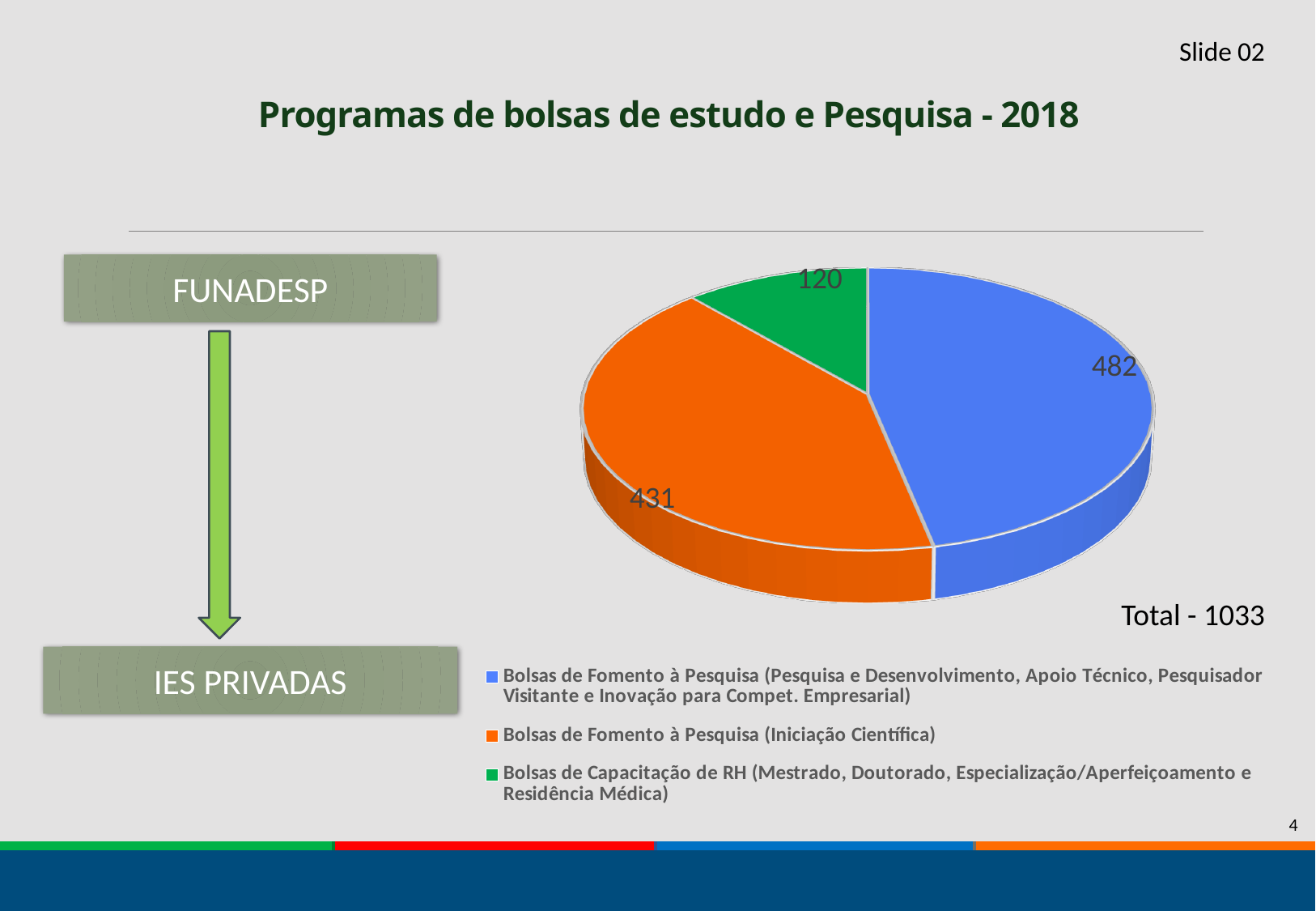
What total is printed next to the pie chart? Total - 1033 What is the value for Bolsas de Capacitação de RH (Mestrado, Doutorado, Especialização/Aperfeiçoamento e Residência Médica)? 120 What is the difference between the value for Bolsas de Fomento à Pesquisa (Iniciação Científica) and the value for Bolsas de Capacitação de RH? 311 Which is larger: the slice for Bolsas de Fomento à Pesquisa (Iniciação Científica) or the slice for Bolsas de Capacitação de RH? Bolsas de Fomento à Pesquisa (Iniciação Científica) Which category has the smallest slice of the pie? Bolsas de Capacitação de RH (Mestrado, Doutorado, Especialização/Aperfeiçoamento e Residência Médica) What is the difference between the largest slice (482) and the Iniciação Científica slice (431)? 51 What kind of chart is shown on the slide? Pie chart What colour is the slice for Bolsas de Fomento à Pesquisa (Iniciação Científica)? Orange Which category has the largest slice of the pie? Bolsas de Fomento à Pesquisa (Pesquisa e Desenvolvimento, Apoio Técnico, Pesquisador Visitante e Inovação para Compet. Empresarial) What is the value for Bolsas de Fomento à Pesquisa (Pesquisa e Desenvolvimento, Apoio Técnico, Pesquisador Visitante e Inovação para Compet. Empresarial)? 482 What is the value for Bolsas de Fomento à Pesquisa (Iniciação Científica)? 431 How many slices does the pie chart have? 3